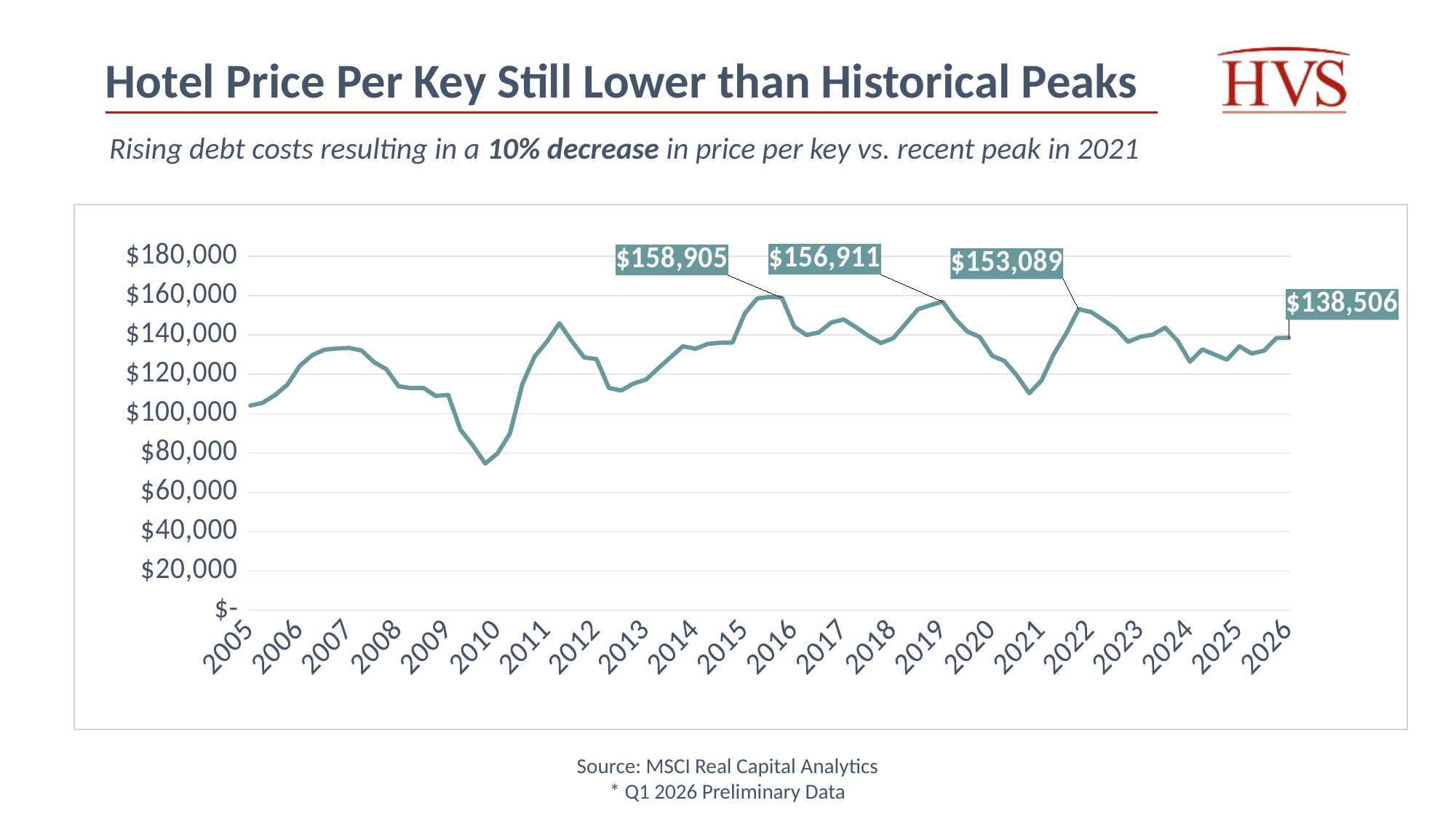
What is the difference between the labeled peak of $158,905 and the final labeled value of $138,506? $20,399 Is the value at 2007 greater or less than $120,000? greater How many year labels are shown on the x axis? 22 What is the value of the final data point on the chart, labeled at 2026? $138,506 What kind of chart is shown on the slide? line chart What is the difference between the labeled values $153,089 and $138,506? $14,583 Is the value at the 2010 trough greater or less than $80,000? less Does the line rise or fall between 2007 and 2010? fall What is the lowest value printed as a data label on the chart? $138,506 What is the title of the slide? Hotel Price Per Key Still Lower than Historical Peaks Which labeled value is larger, $156,911 or $153,089? $156,911 What is the highest value printed as a data label on the chart? $158,905